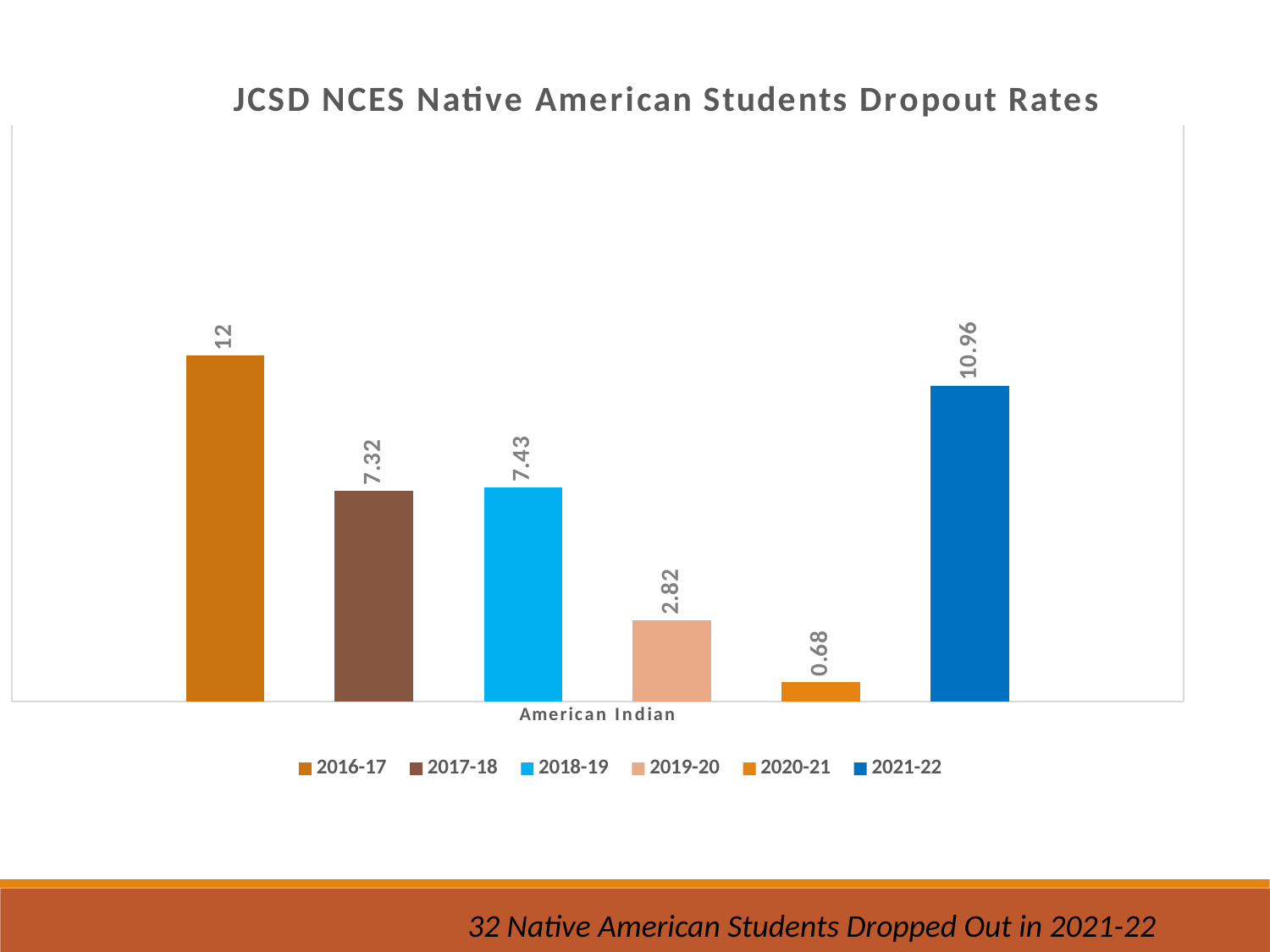
What is the difference between the dropout rates for 2016-17 and 2021-22? 1.04 What kind of chart is shown on the slide? Bar chart Which school year has the lowest dropout rate? 2020-21 What is the category label shown on the x axis? American Indian How many series does the legend list? 6 Which school year has the highest dropout rate? 2016-17 What is the dropout rate for 2016-17? 12 What is the dropout rate for 2019-20? 2.82 What is the dropout rate for 2021-22? 10.96 What is the title of the chart? JCSD NCES Native American Students Dropout Rates Which has a higher dropout rate, 2017-18 or 2021-22? 2021-22 What is the difference between the dropout rates for 2019-20 and 2020-21? 2.14